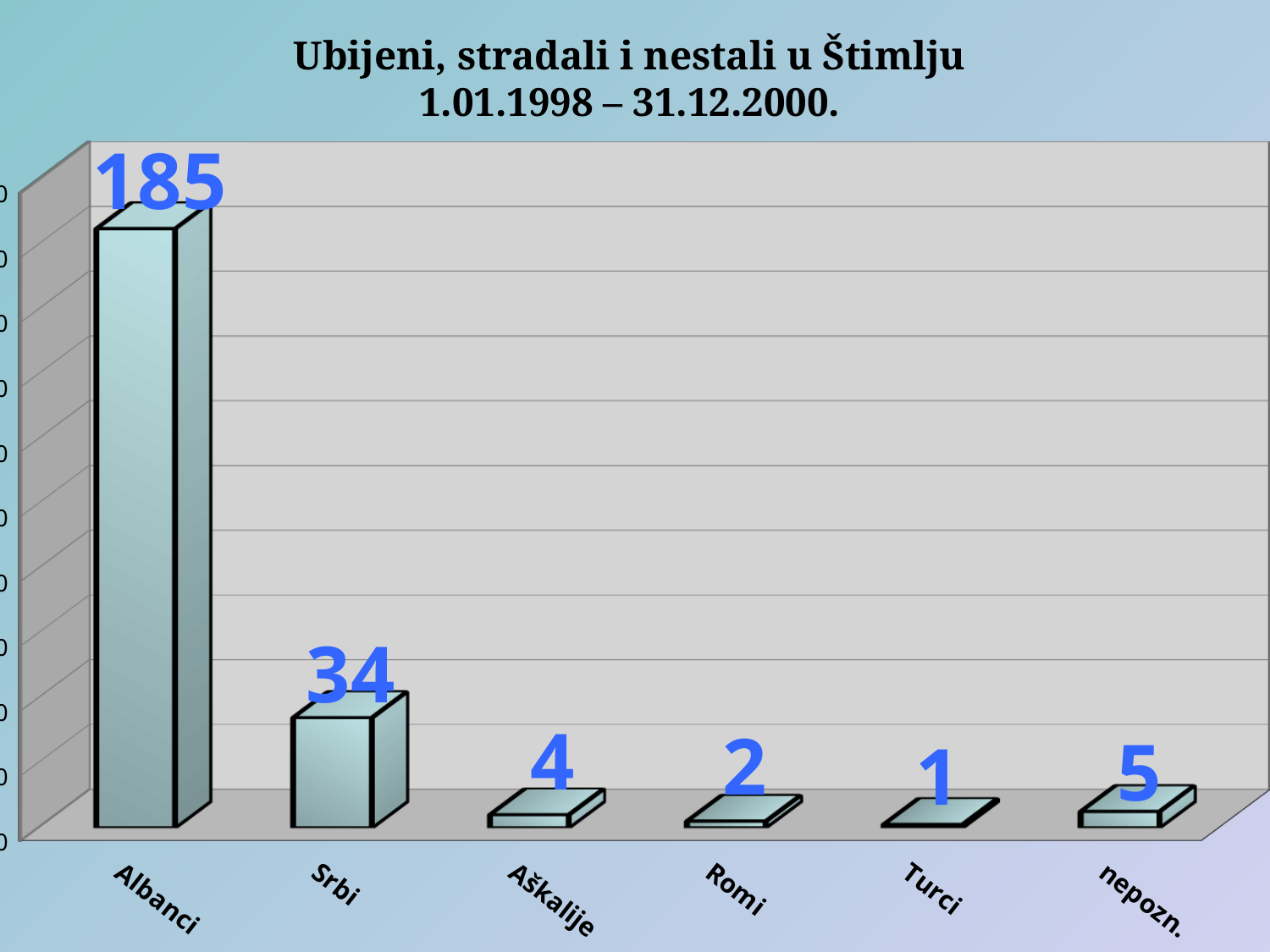
What is the value for nepozn.? 5 What is the value for Srbi? 34 What kind of chart is shown on the slide? Bar chart What is the value for Romi? 2 Which is larger, the value for nepozn. or the value for Aškalije? nepozn. What is the value for Aškalije? 4 What is the value for Albanci? 185 How many categories are shown on the chart? 6 Which category has the highest value? Albanci What is the value for Turci? 1 Which category has the lowest value? Turci What is the difference between the values for Albanci and Srbi? 151